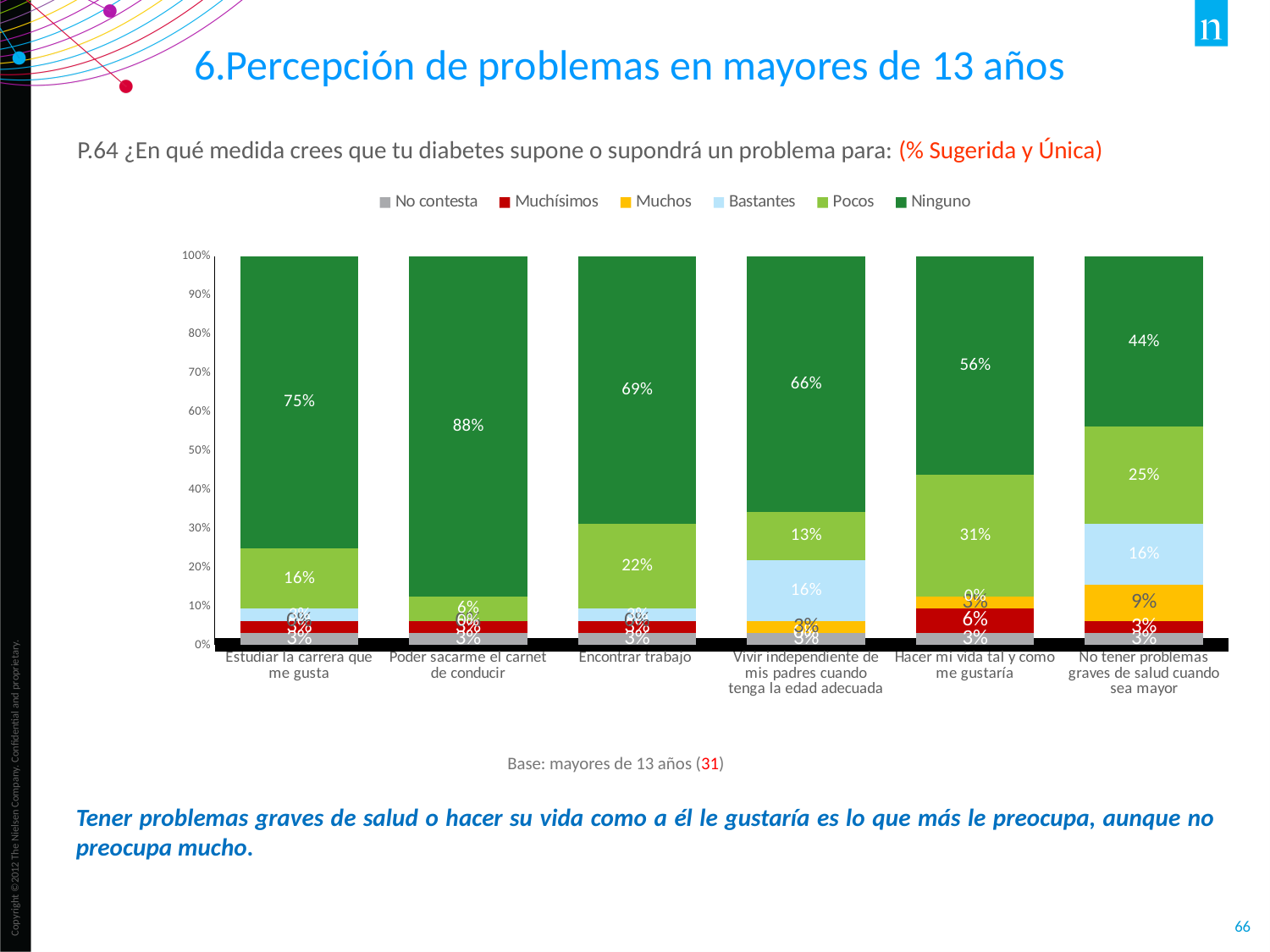
What is the 'Muchos' value for 'No tener problemas graves de salud cuando sea mayor'? 9% What is the difference between the 'Ninguno' values for 'Estudiar la carrera que me gusta' and 'Encontrar trabajo'? 6% What type of chart is shown on the slide? stacked bar chart How many series does the legend list? 6 Which category has the highest 'Ninguno' value? Poder sacarme el carnet de conducir How many categories are shown on the x axis? 6 Which category has the lowest 'Ninguno' value? No tener problemas graves de salud cuando sea mayor What is the 'Pocos' value for 'Hacer mi vida tal y como me gustaría'? 31% What is the 'Bastantes' value for 'Vivir independiente de mis padres cuando tenga la edad adecuada'? 16% Which is larger, the 'Pocos' value for 'Encontrar trabajo' or for 'Vivir independiente de mis padres cuando tenga la edad adecuada'? Encontrar trabajo What is the 'Ninguno' value for 'No tener problemas graves de salud cuando sea mayor'? 44% What is the 'Ninguno' value for 'Poder sacarme el carnet de conducir'? 88%